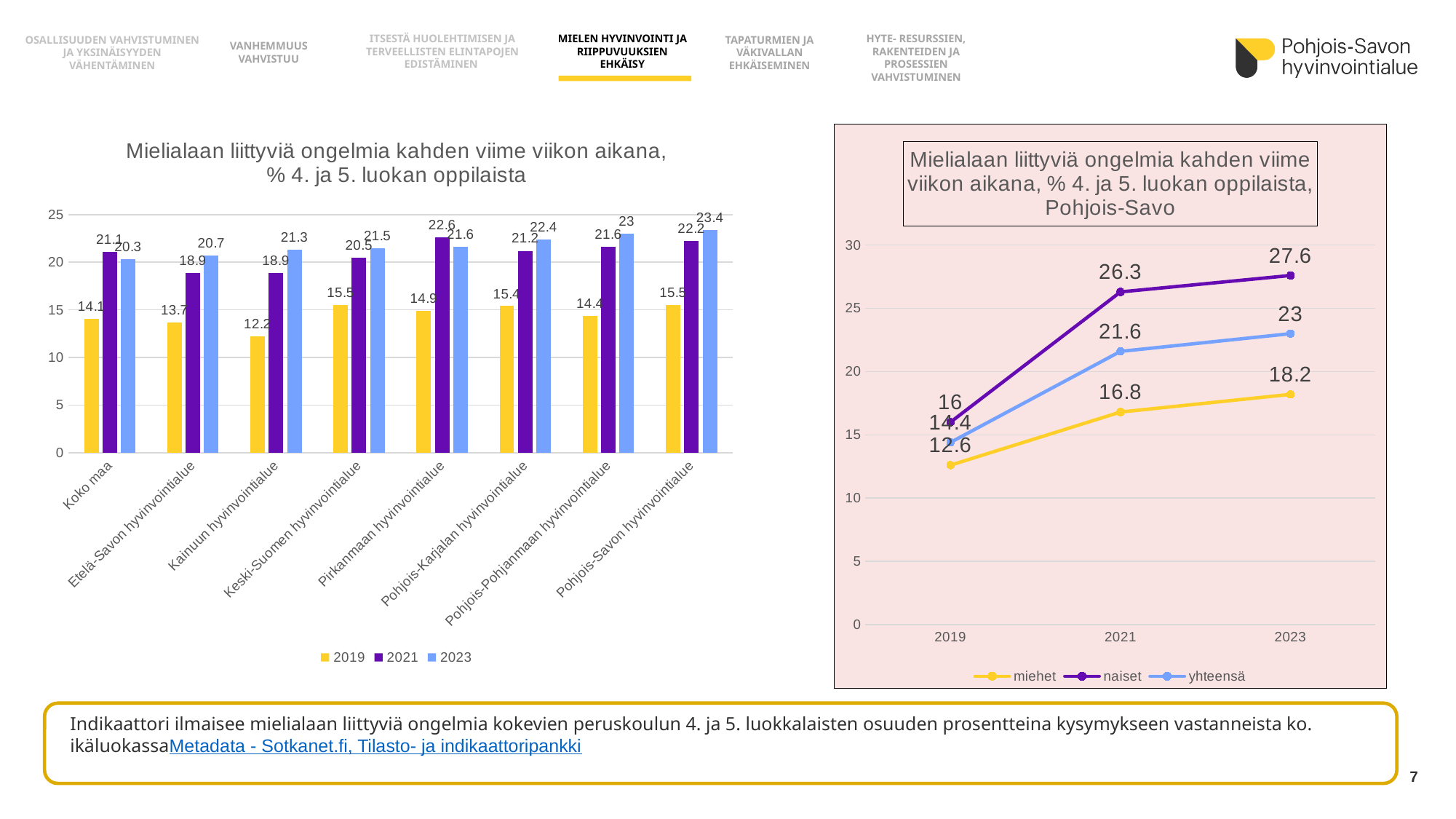
In the left bar chart, what is the 2019 value for Kainuun hyvinvointialue? 12.2 In the left bar chart, what is the difference between the 2021 and 2019 values for Koko maa? 7 In the right line chart, does the miehet series rise or fall from 2019 to 2023? rise In the right line chart, what is the difference between naiset and miehet in 2023? 9.4 How many series does the legend of the left bar chart list? 3 In the left bar chart, is the 2021 value for Pirkanmaan hyvinvointialue larger or smaller than its 2023 value? larger In the left bar chart, what is the 2023 value for Pohjois-Savon hyvinvointialue? 23.4 In the left bar chart, which region has the highest 2023 value? Pohjois-Savon hyvinvointialue In the right line chart, what is the value for naiset in 2021? 26.3 How many regions are shown on the x axis of the left bar chart? 8 In the left bar chart, which region has the lowest 2019 value? Kainuun hyvinvointialue What type of chart is the chart on the right side of the slide? line chart